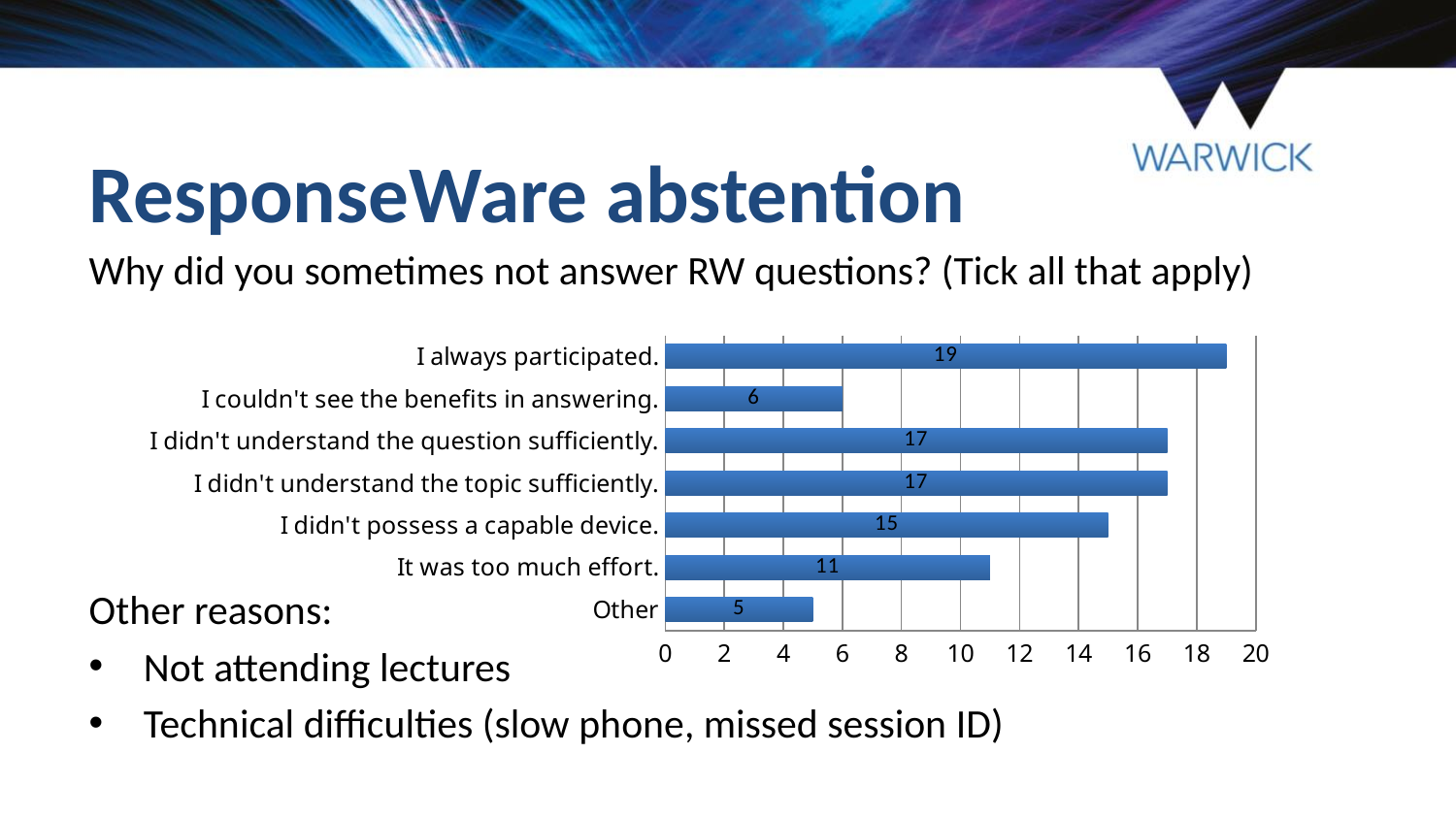
What is the maximum value shown on the horizontal axis? 20 Which category has the highest value? I always participated. What value is shown for "Other"? 5 Which is larger: the value for "I didn't possess a capable device." or the value for "It was too much effort."? I didn't possess a capable device. Which category has the lowest value? Other What value is shown for "I didn't possess a capable device."? 15 What value is shown for "I always participated."? 19 What value is shown for "It was too much effort."? 11 Is the value for "I didn't understand the topic sufficiently." greater or less than 10? greater How many categories are shown in the chart? 7 What is the difference between the values for "I always participated." and "I couldn't see the benefits in answering."? 13 What kind of chart is shown on the slide? bar chart